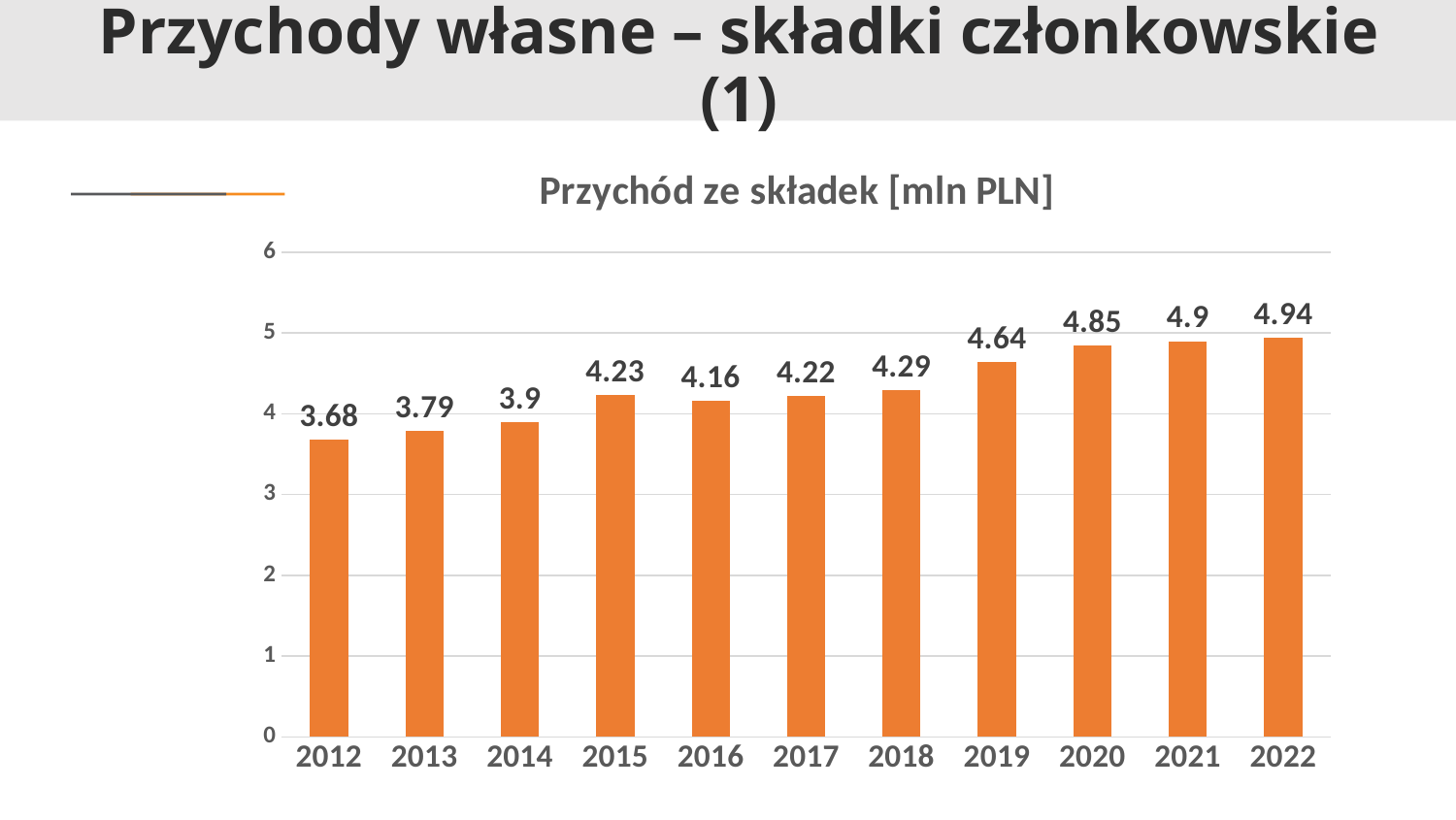
What is the value for 2019? 4.64 Which year has the lowest value? 2012 What kind of chart is this? bar chart What is the title of the chart? Przychód ze składek [mln PLN] Which is larger, the value for 2015 or the value for 2016? 2015 Which year has the highest value? 2022 How many years are shown on the x axis? 11 Is the value for 2020 greater or less than 4? greater What is the value for 2016? 4.16 What is the value for 2012? 3.68 Do the values generally rise or fall from 2012 to 2022? rise What is the difference between the values for 2022 and 2012? 1.26